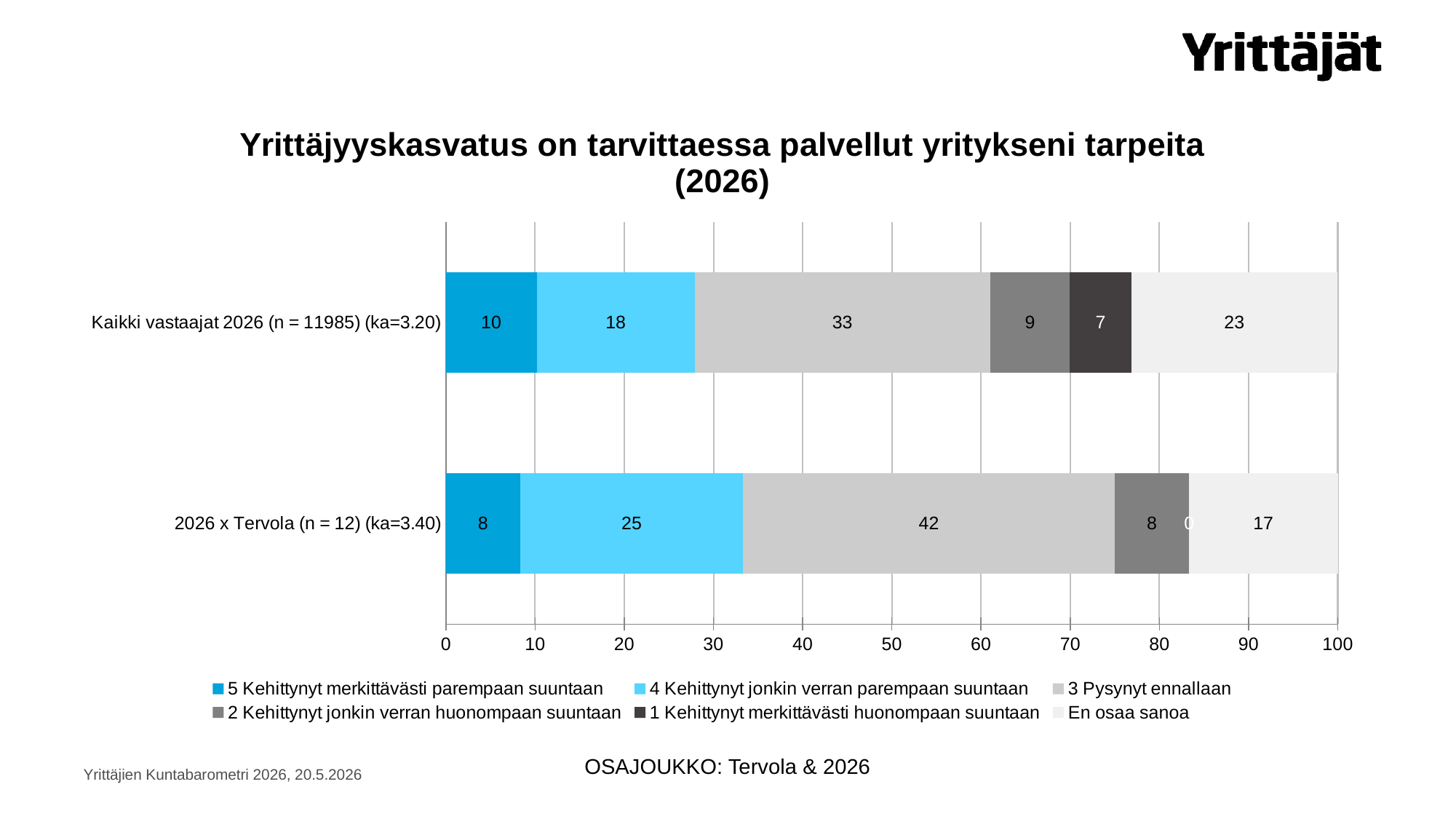
What is the value of '3 Pysynyt ennallaan' for '2026 x Tervola (n = 12) (ka=3.40)'? 42 What is the value of 'En osaa sanoa' for 'Kaikki vastaajat 2026 (n = 11985) (ka=3.20)'? 23 What is the difference between the '3 Pysynyt ennallaan' values for '2026 x Tervola (n = 12) (ka=3.40)' and 'Kaikki vastaajat 2026 (n = 11985) (ka=3.20)'? 9 What is the total of the stacked bar for '2026 x Tervola (n = 12) (ka=3.40)'? 100 How many series does the legend list? 6 What is the value of '1 Kehittynyt merkittävästi huonompaan suuntaan' for '2026 x Tervola (n = 12) (ka=3.40)'? 0 Which series has the highest value in the 'Kaikki vastaajat 2026 (n = 11985) (ka=3.20)' bar? 3 Pysynyt ennallaan Which category has the larger value for '4 Kehittynyt jonkin verran parempaan suuntaan'? 2026 x Tervola (n = 12) (ka=3.40) What kind of chart is shown on the slide? Stacked bar chart What is the value of '4 Kehittynyt jonkin verran parempaan suuntaan' for 'Kaikki vastaajat 2026 (n = 11985) (ka=3.20)'? 18 How many categories (bars) are plotted in the chart? 2 What is the title of the chart? Yrittäjyyskasvatus on tarvittaessa palvellut yritykseni tarpeita (2026)